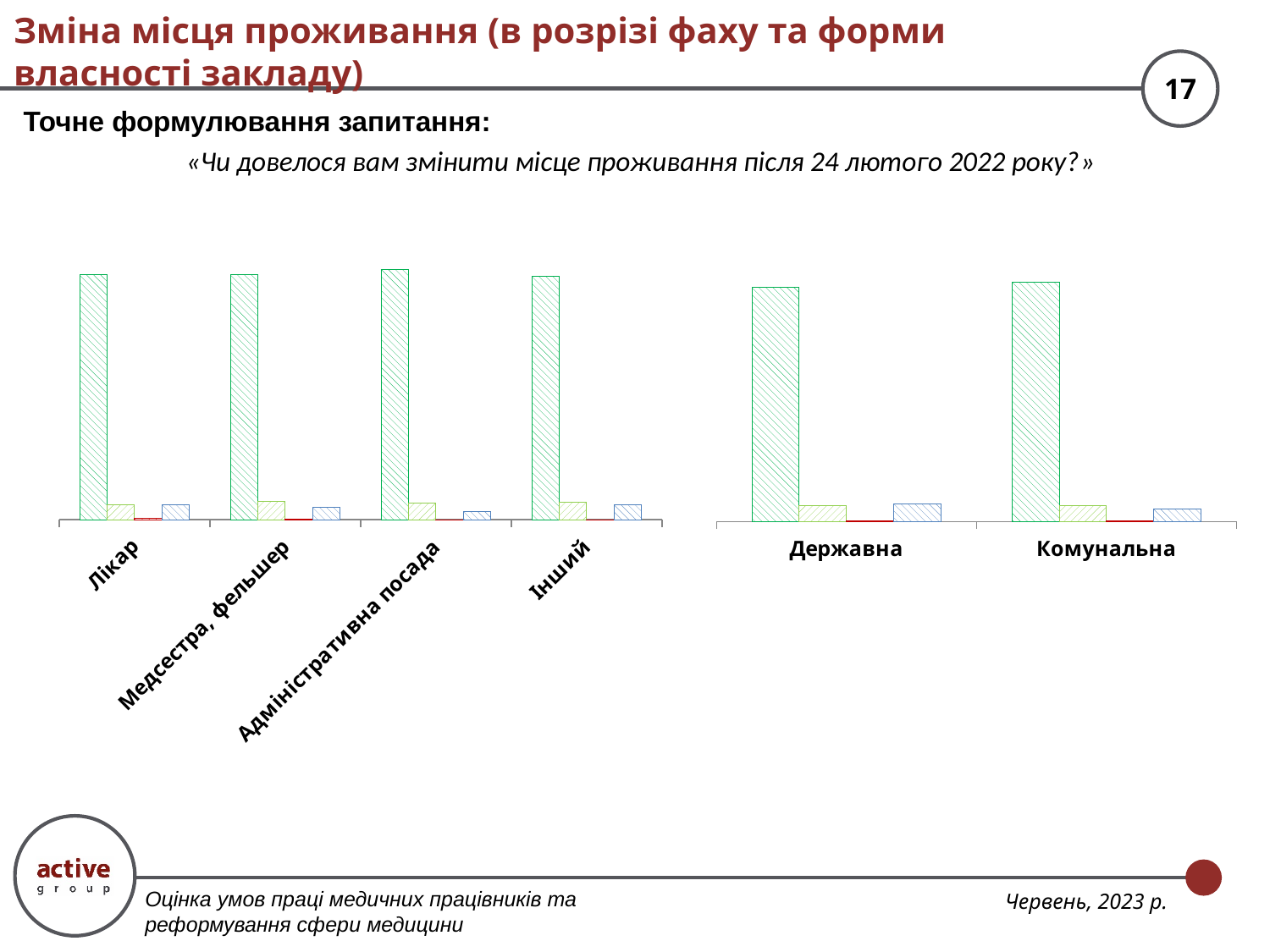
What kind of chart is the right chart on the slide? bar chart How many categories are shown on the x axis of the right chart? 2 In the left chart, for the category Інший, which bar is the shortest: the first, second, third or fourth? third In the right chart, which two categories are shown on the x axis? Державна, Комунальна What kind of chart is the left chart on the slide? bar chart How many categories are shown on the x axis of the left chart? 4 In the left chart, for the category Лікар, is the first (green hatched) bar larger or smaller than the second bar? larger In the right chart, for the category Комунальна, is the first (green hatched) bar larger or smaller than the last (blue) bar? larger How many bars are plotted for each category in the left chart? 4 What is the last category listed on the x axis of the left chart? Інший In the right chart, for the category Державна, which bar is the tallest: the first, second, third or fourth? first